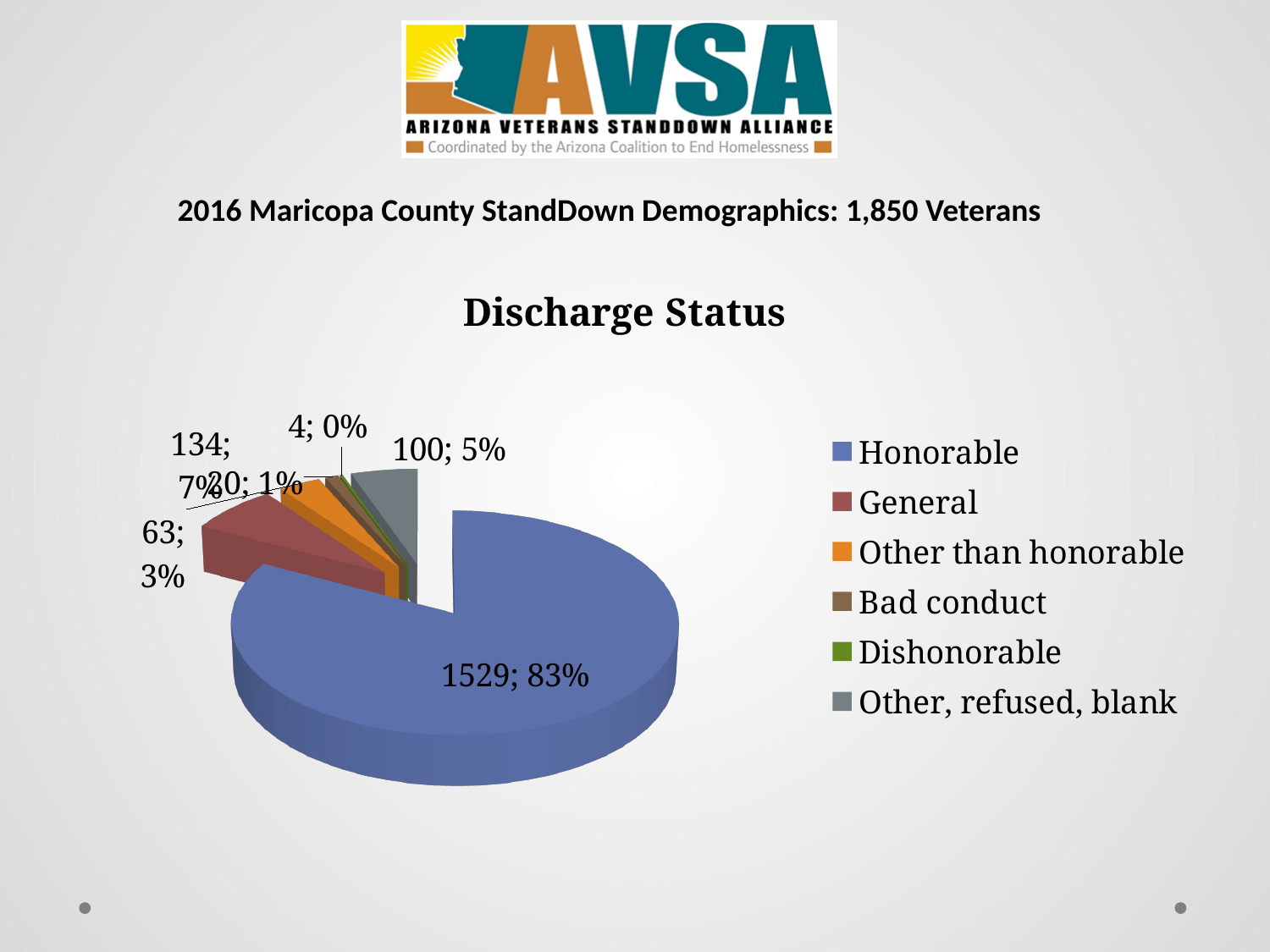
What share of the pie does the Honorable slice represent? 83% What is the title of the chart? Discharge Status Which discharge status category is the largest? Honorable Which is larger, the General slice or the Other, refused, blank slice? General What percentage of the pie is Other, refused, blank? 5% Which discharge status category is the smallest? Dishonorable How many veterans fall under Other, refused, blank? 100 How many veterans had a Dishonorable discharge? 4 What is the difference between the Honorable count and the Other, refused, blank count? 1429 How many categories does the legend list? 6 How many veterans had an Honorable discharge status? 1529 What kind of chart is shown on the slide? Pie chart